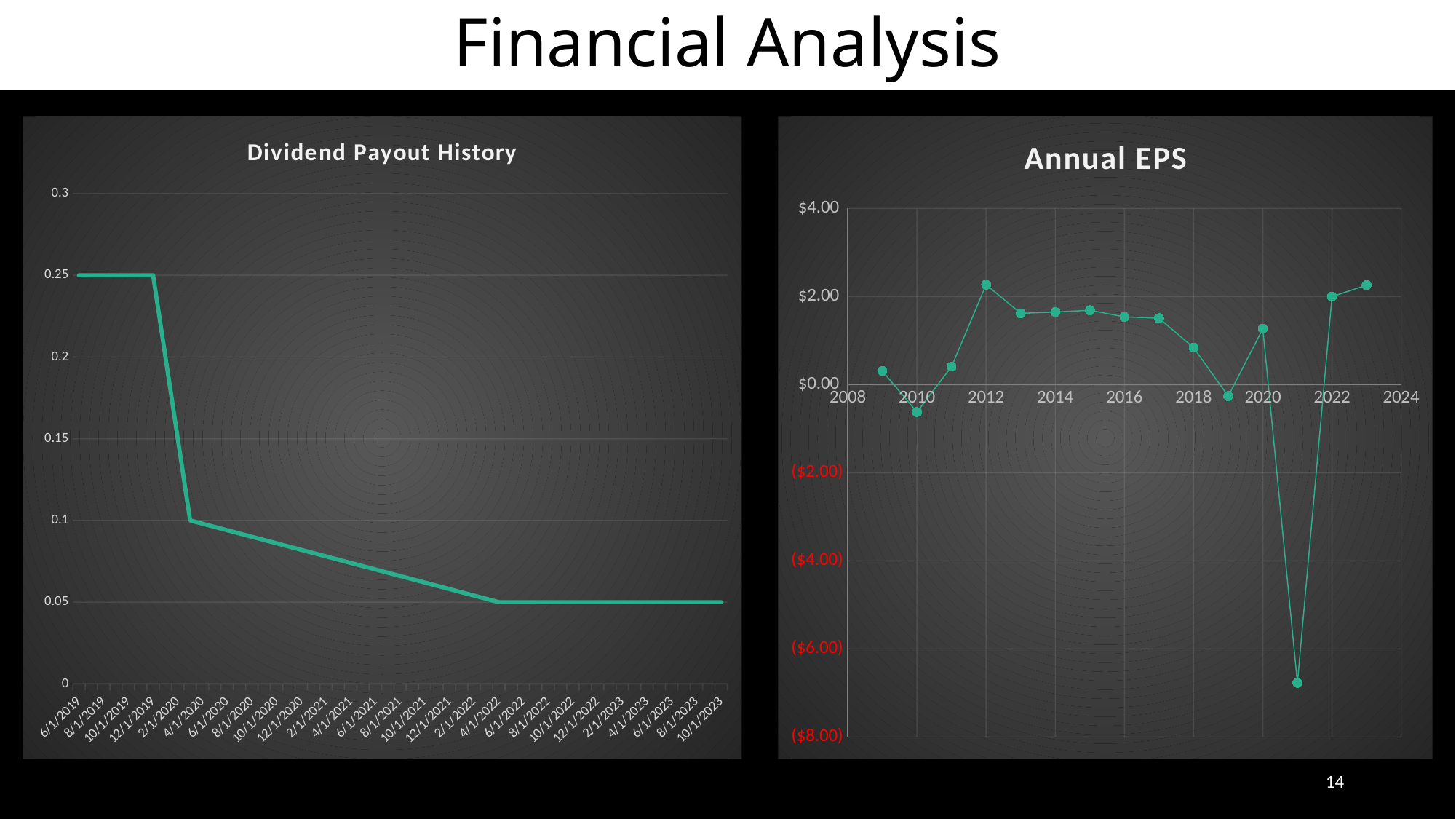
What kind of chart is the Annual EPS chart? line chart In the Annual EPS chart, is the value for 2021 greater or less than ($6.00)? less In the Dividend Payout History chart, what is the dividend value at 10/1/2023? 0.05 What kind of chart is the Dividend Payout History chart? line chart In the Dividend Payout History chart, what is the dividend value at 6/1/2019? 0.25 In the Annual EPS chart, which year has the lowest EPS? 2021 In the Dividend Payout History chart, do the dividend values rise or fall over time along the x axis? fall In the Annual EPS chart, is the value for 2012 greater or less than $2.00? greater In the Annual EPS chart, which is larger, the EPS for 2020 or the EPS for 2019? 2020 In the Annual EPS chart, is the value for 2010 greater or less than $0.00? less In the Dividend Payout History chart, what is the difference between the dividend at 6/1/2019 and the dividend at 10/1/2023? 0.2